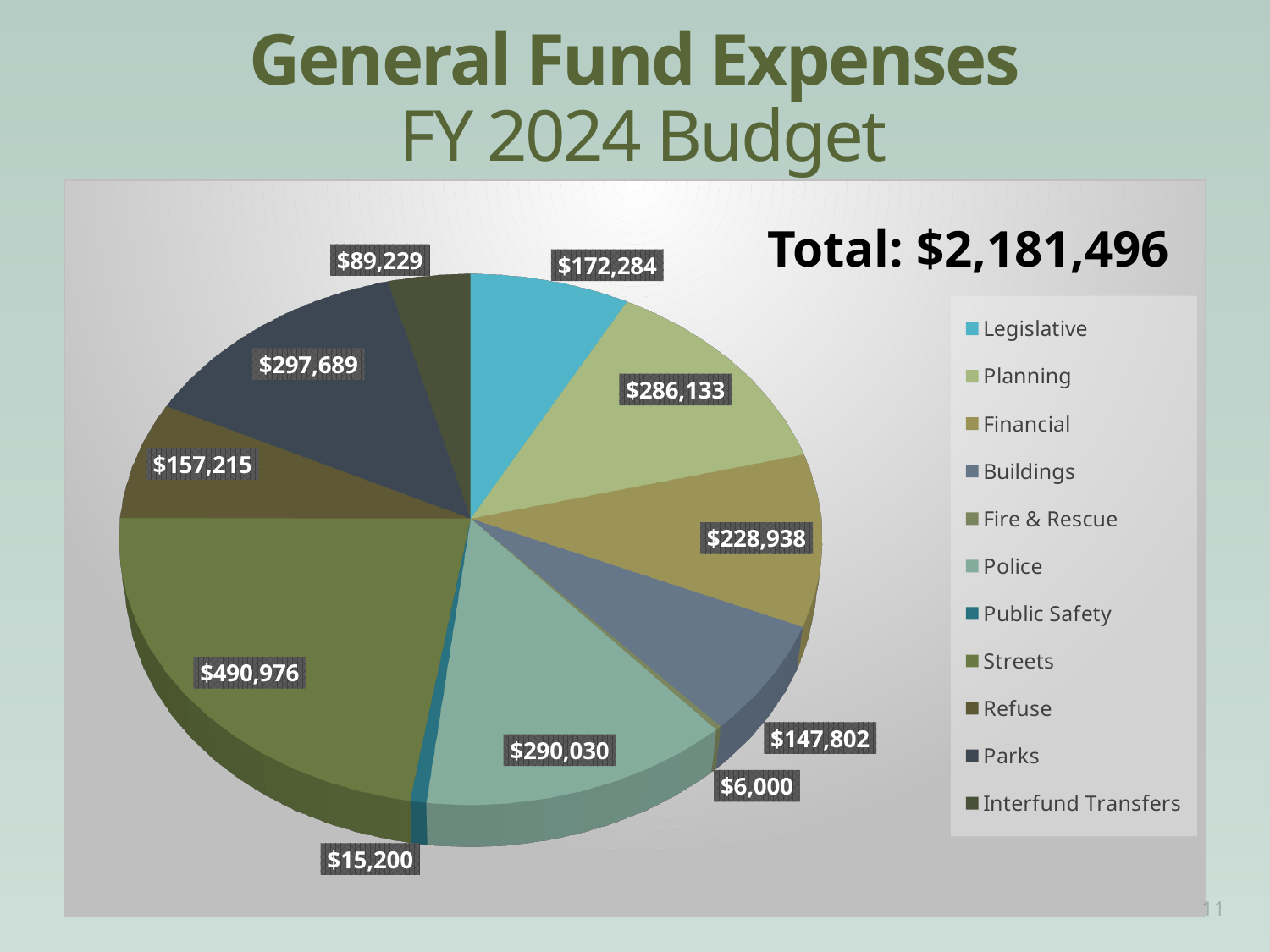
What is the budgeted expense for Parks? $297,689 What total is shown for General Fund Expenses? $2,181,496 What is the budgeted expense for Legislative? $172,284 What is the budgeted expense for Fire & Rescue? $6,000 What is the budgeted expense for Streets? $490,976 Which is larger, the Financial expense or the Buildings expense? Financial Which category has the smallest expense? Fire & Rescue How many expense categories does the legend list? 11 What is the difference between the Streets expense and the Planning expense? $204,843 Which category has the largest expense? Streets What type of chart is shown on the slide? Pie chart What is the difference between the Parks expense and the Police expense? $7,659